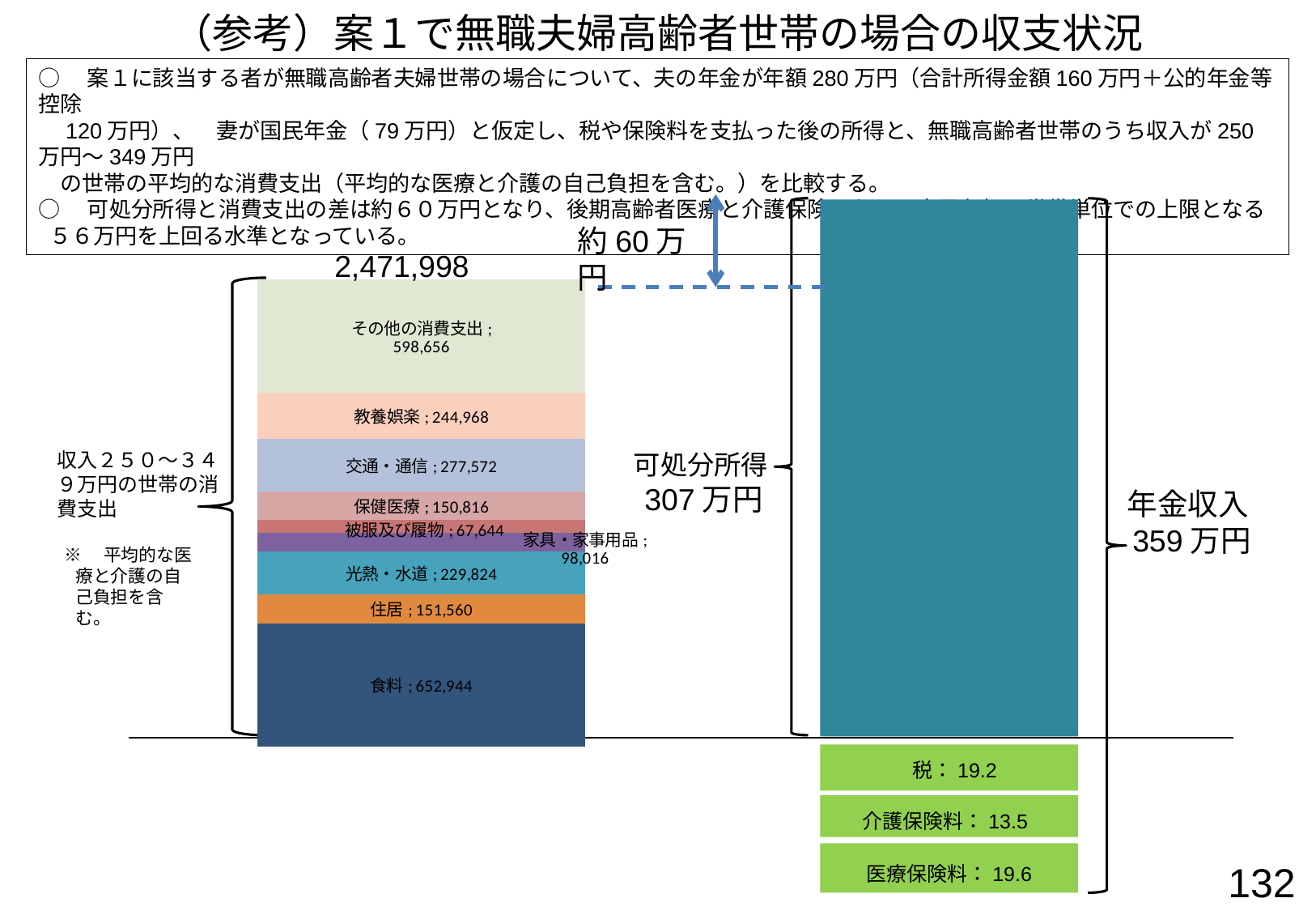
In the consumption expenditure stacked bar, which is larger: 教養娯楽 or 光熱・水道? 教養娯楽 What is the total of the consumption expenditure stacked bar? 2,471,998 What kind of chart is used to show the consumption expenditure breakdown? Stacked bar chart In the stacked bar of consumption expenditure, what is the value for 食料? 652,944 What is the value shown for 年金収入 on the right-hand bar? 359万円 In the stacked bar of consumption expenditure, what is the value for 交通・通信? 277,572 What is the difference between 食料 and その他の消費支出 in the consumption expenditure stacked bar? 54,288 Which segment of the consumption expenditure stacked bar has the smallest value? 被服及び履物 How many segments make up the consumption expenditure stacked bar? 9 Which segment of the consumption expenditure stacked bar has the largest value? 食料 What is the value shown for 税 below the pension income bar? 19.2 In the stacked bar of consumption expenditure, what is the value for 家具・家事用品? 98,016